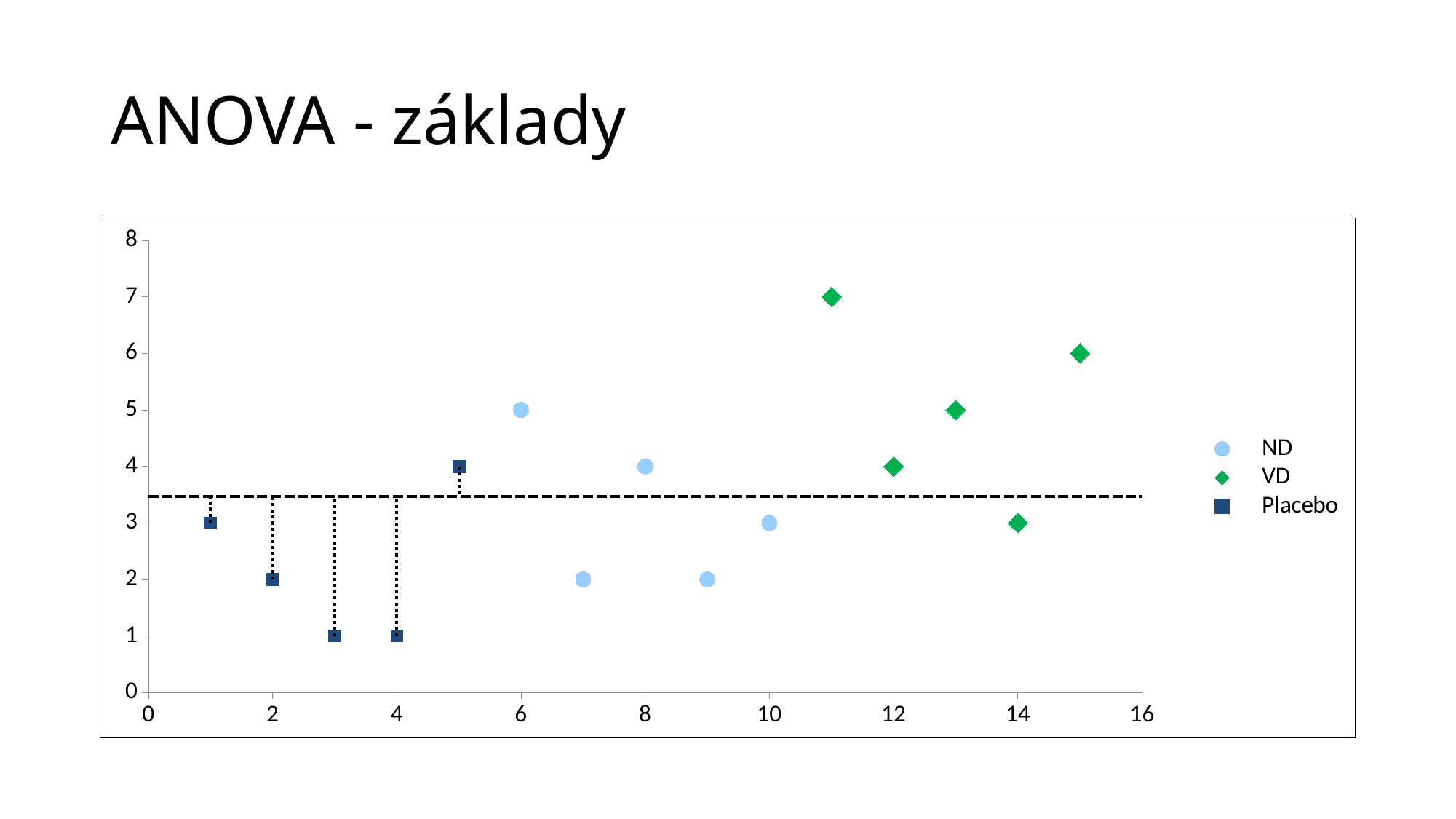
What is the lowest y value among the Placebo points? 1 Which is larger: the y value of the VD point at x = 15 or the ND point at x = 8? VD point at x = 15 What is the difference between the y value of the VD point at x = 11 and the ND point at x = 6? 2 What kind of chart is shown on the slide? scatter chart Is the y value of the Placebo point at x = 5 greater or less than 3? greater How many series does the legend list? 3 What is the y value of the ND point at x = 6? 5 What is the y value of the VD point at x = 11? 7 Which series contains the highest point on the chart? VD What is the y value of the Placebo point at x = 1? 3 Which series are listed in the legend? ND, VD, Placebo How many Placebo points are plotted? 5